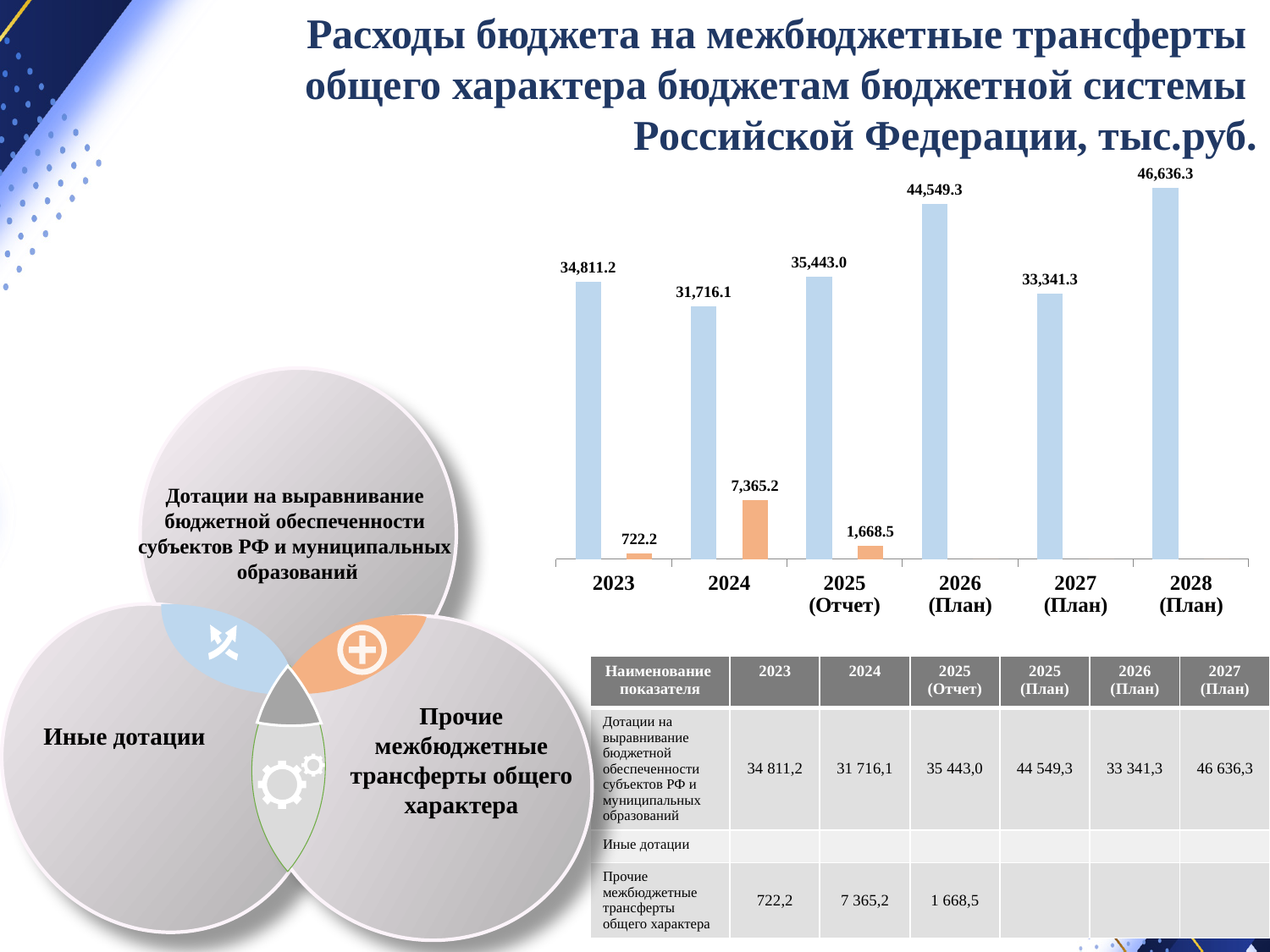
Which year has the highest blue bar? 2028 (План) What is the difference between the blue bar values for 2028 (План) and 2027 (План)? 13,295.0 How many orange bars are plotted on the chart? 3 Which is larger, the blue bar for 2025 (Отчет) or the blue bar for 2023? 2025 (Отчет) What type of chart is shown on the slide? bar chart What is the value of the orange bar for 2023? 722.2 What is the value of the blue bar for 2025 (Отчет)? 35,443.0 How many year categories are shown on the x axis of the chart? 6 Which year has the lowest blue bar? 2024 What is the value of the orange bar for 2024? 7,365.2 What is the difference between the orange bar values for 2024 and 2023? 6,643.0 What is the value of the blue bar for 2026 (План)? 44,549.3